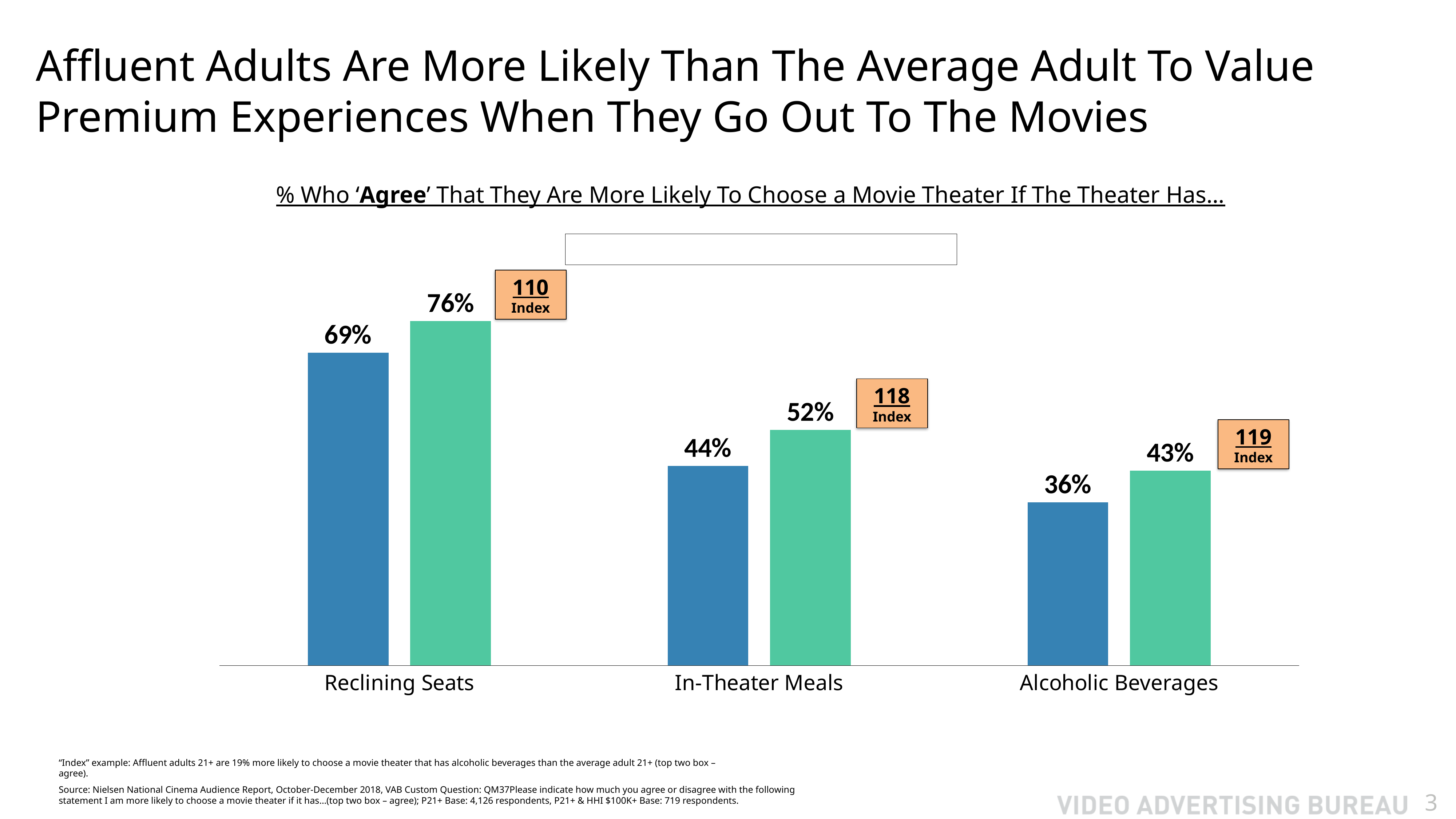
How many categories are shown on the x axis? 3 Do the blue bar values rise or fall from left to right across the categories? Fall Which category has the lowest blue bar? Alcoholic Beverages For Alcoholic Beverages, which is larger, the blue bar or the green bar? The green bar (43%) What is the value of the blue bar for Reclining Seats? 69% What is the difference between the green bar and the blue bar for Reclining Seats? 7 percentage points Which category has the highest green bar? Reclining Seats What is the value of the green bar for In-Theater Meals? 52% What index value is shown for Alcoholic Beverages? 119 What is the value of the blue bar for Alcoholic Beverages? 36% What is the difference between the green bar and the blue bar for In-Theater Meals? 8 percentage points What kind of chart is shown on the slide? Bar chart